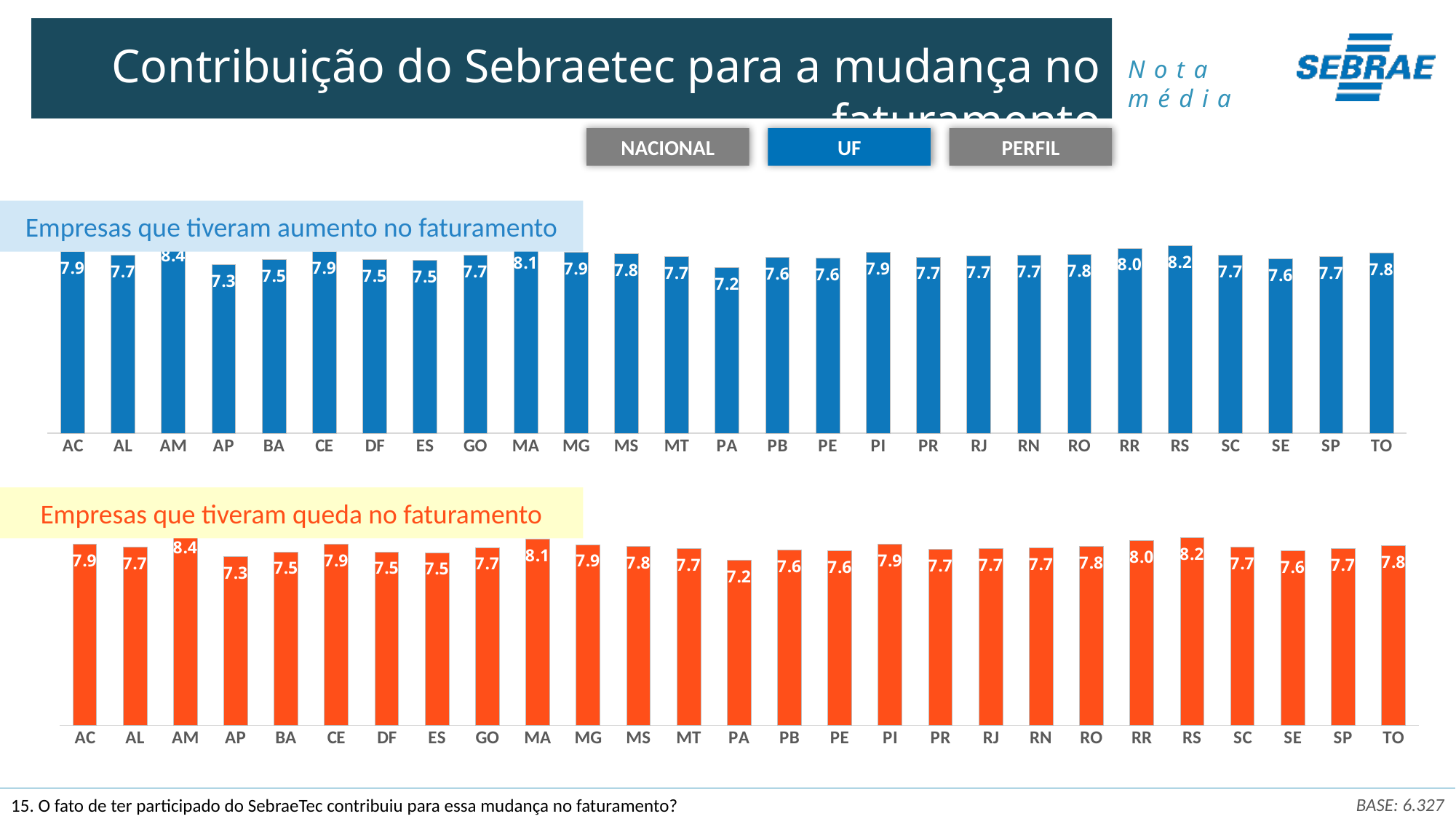
In the chart 'Empresas que tiveram aumento no faturamento', which is larger, the value for MA or the value for MG? MA In the chart 'Empresas que tiveram aumento no faturamento', which state has the lowest value? PA In the chart 'Empresas que tiveram queda no faturamento', what is the value for PA? 7.2 What colour are the bars in the chart 'Empresas que tiveram queda no faturamento'? Orange How many states are shown in the chart 'Empresas que tiveram aumento no faturamento'? 27 In the chart 'Empresas que tiveram queda no faturamento', which is larger, the value for RR or the value for BA? RR In the chart 'Empresas que tiveram queda no faturamento', which state has the highest value? AM What type of chart is 'Empresas que tiveram queda no faturamento'? Bar chart In the chart 'Empresas que tiveram aumento no faturamento', what is the value for AM? 8.4 In the chart 'Empresas que tiveram queda no faturamento', what is the difference between the values for RS and AP? 0.9 In the chart 'Empresas que tiveram aumento no faturamento', what is the value for RS? 8.2 In the chart 'Empresas que tiveram aumento no faturamento', what is the difference between the values for AM and PA? 1.2